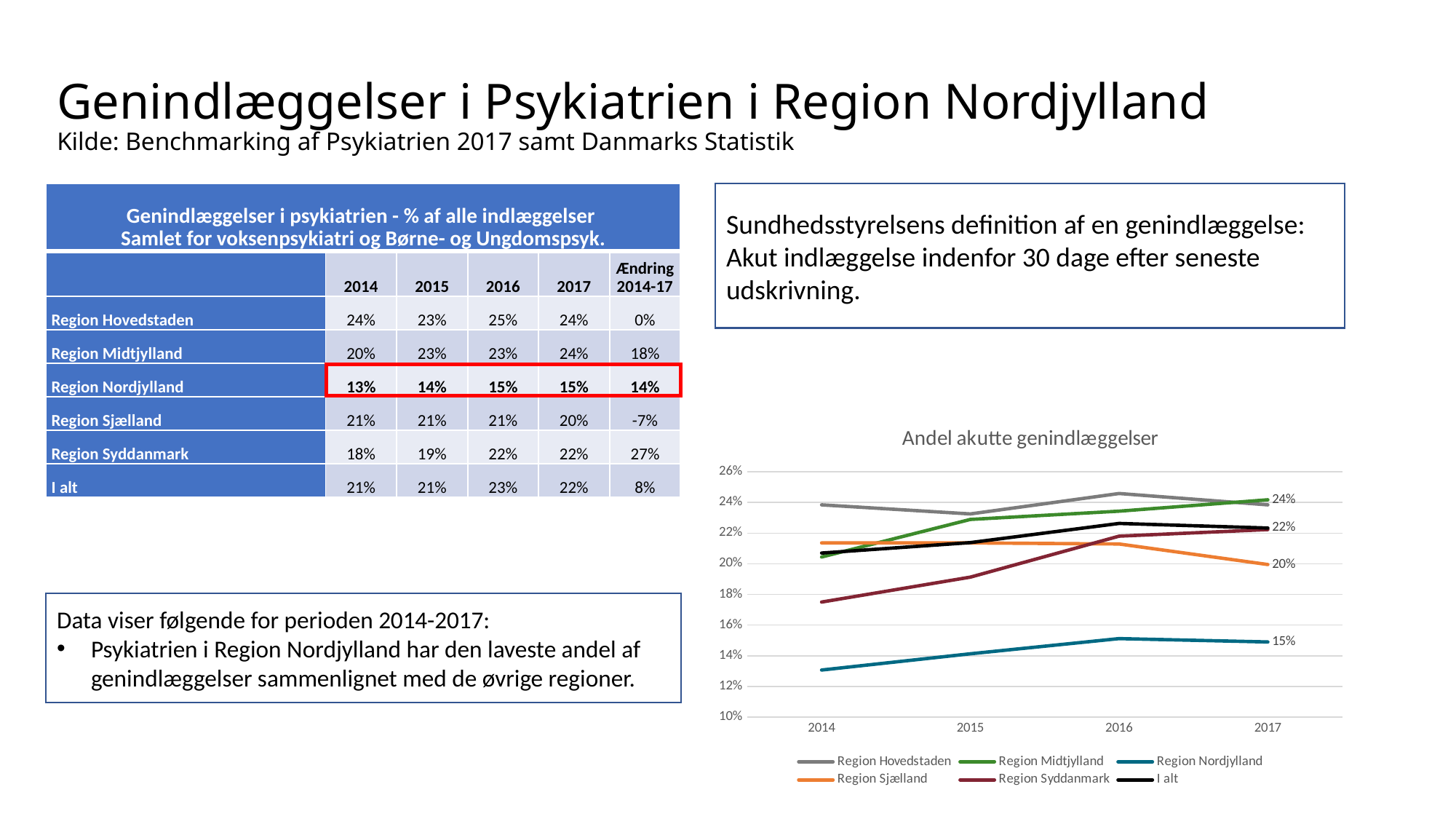
How many years are shown on the x axis of the "Andel akutte genindlæggelser" chart? 4 What kind of chart is shown under the title "Andel akutte genindlæggelser"? line chart In the "Andel akutte genindlæggelser" chart, does the Region Sjælland line rise or fall from 2016 to 2017? fall In the "Andel akutte genindlæggelser" chart, what is the value for Region Sjælland in 2017? 20% In the "Andel akutte genindlæggelser" chart, is the value for Region Syddanmark in 2014 greater or less than 18%? less In the "Andel akutte genindlæggelser" chart, what is the difference between the 2017 values for Region Sjælland and Region Nordjylland? 5 percentage points In the "Andel akutte genindlæggelser" chart, is the value for Region Nordjylland in 2014 greater or less than 14%? less In the "Andel akutte genindlæggelser" chart, which is larger in 2014: Region Hovedstaden or Region Nordjylland? Region Hovedstaden In the "Andel akutte genindlæggelser" chart, which series has the highest value in 2014? Region Hovedstaden In the "Andel akutte genindlæggelser" chart, what is the value for Region Nordjylland in 2017? 15% In the "Andel akutte genindlæggelser" chart, which region has the lowest value in 2017? Region Nordjylland How many series does the legend of the "Andel akutte genindlæggelser" chart list? 6